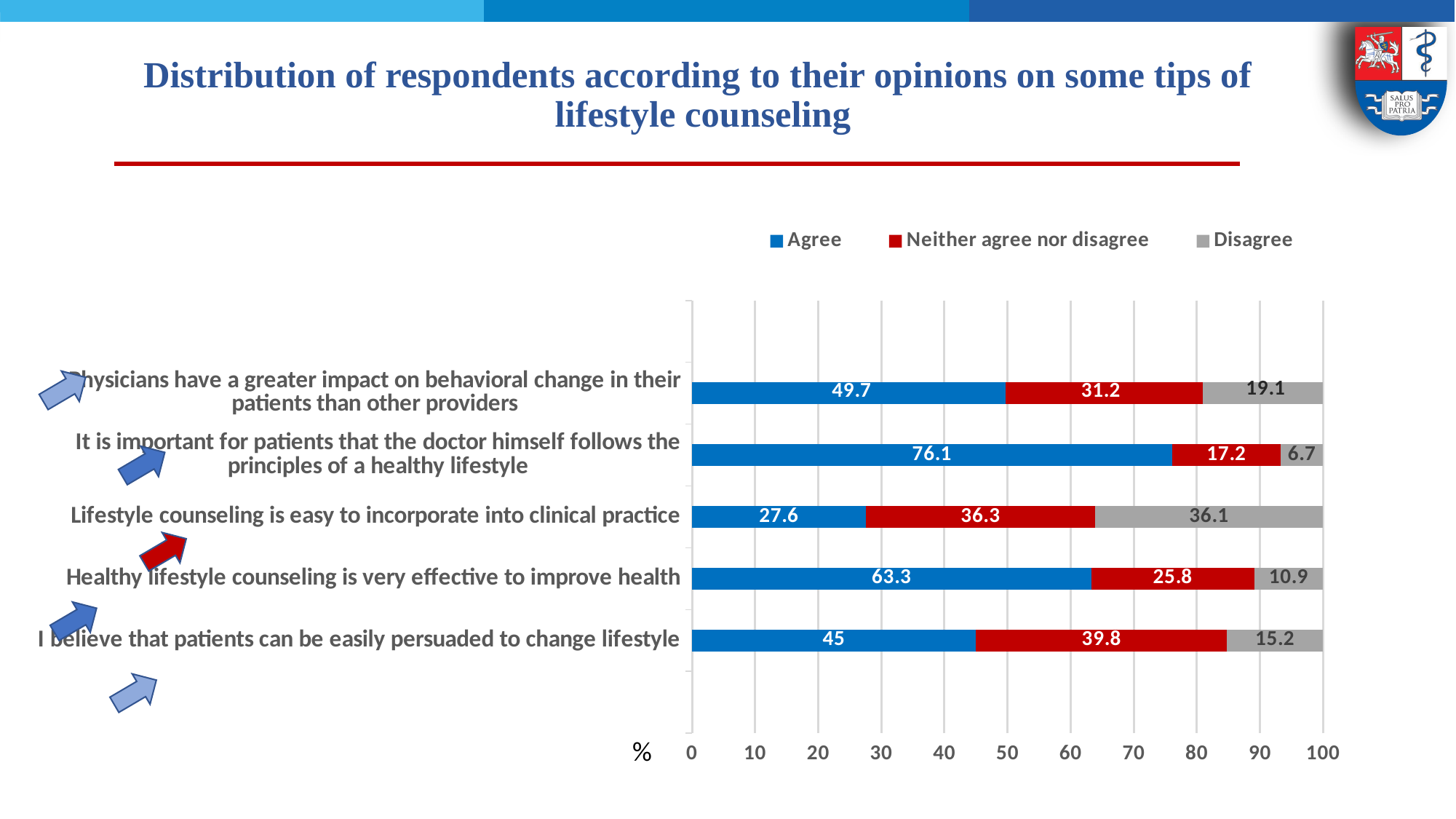
Which statement has the highest Agree value? It is important for patients that the doctor himself follows the principles of a healthy lifestyle Which statement has the lowest Disagree value? It is important for patients that the doctor himself follows the principles of a healthy lifestyle What colour represents the Disagree series in the legend? Grey How many statements are shown on the chart? 5 How many series does the legend list? 3 What percentage of respondents agree that lifestyle counseling is easy to incorporate into clinical practice? 27.6 What is the Disagree value for the statement "Healthy lifestyle counseling is very effective to improve health"? 10.9 What is the "Neither agree nor disagree" value for the statement "I believe that patients can be easily persuaded to change lifestyle"? 39.8 What is the total of the stacked bar for "Healthy lifestyle counseling is very effective to improve health"? 100 Which is larger: the Agree value for "Physicians have a greater impact on behavioral change in their patients than other providers" or the Agree value for "I believe that patients can be easily persuaded to change lifestyle"? Physicians have a greater impact on behavioral change in their patients than other providers What kind of chart is shown on the slide? Stacked bar chart For the statement "Physicians have a greater impact on behavioral change in their patients than other providers", what is the difference between the Agree and Disagree values? 30.6